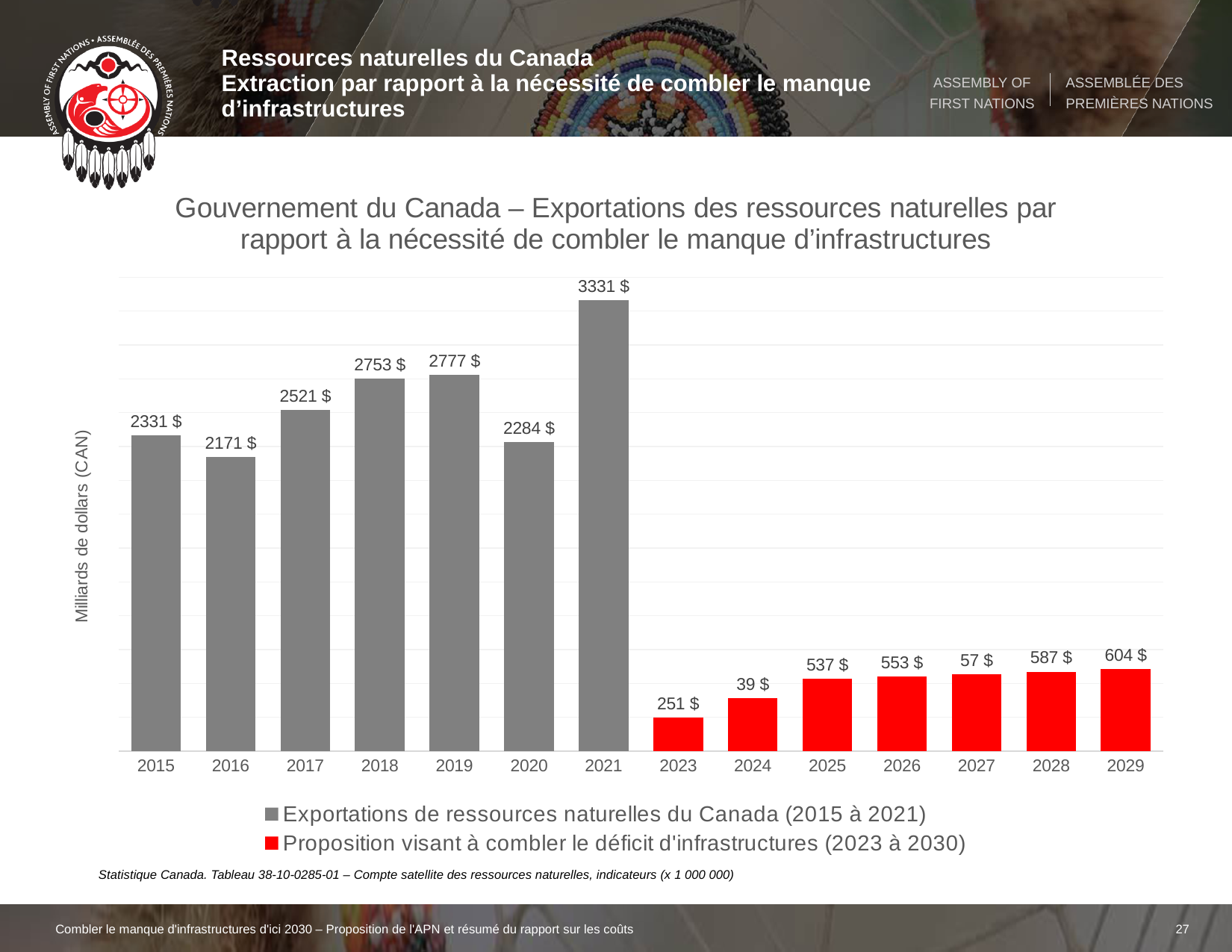
What is the value for 2021? 3331 $ What is the label of the y axis? Milliards de dollars (CAN) What is the value for 2015? 2331 $ What is the difference between the values for 2021 and 2015? 1000 $ What kind of chart is shown on the slide? bar chart How many years are shown on the x axis? 14 What is the difference between the values for 2019 and 2018? 24 $ What is the value for 2029? 604 $ Which is larger, the value for 2017 or the value for 2016? 2017 What is the value for 2025? 537 $ How many series does the legend list? 2 Which year has the highest value? 2021